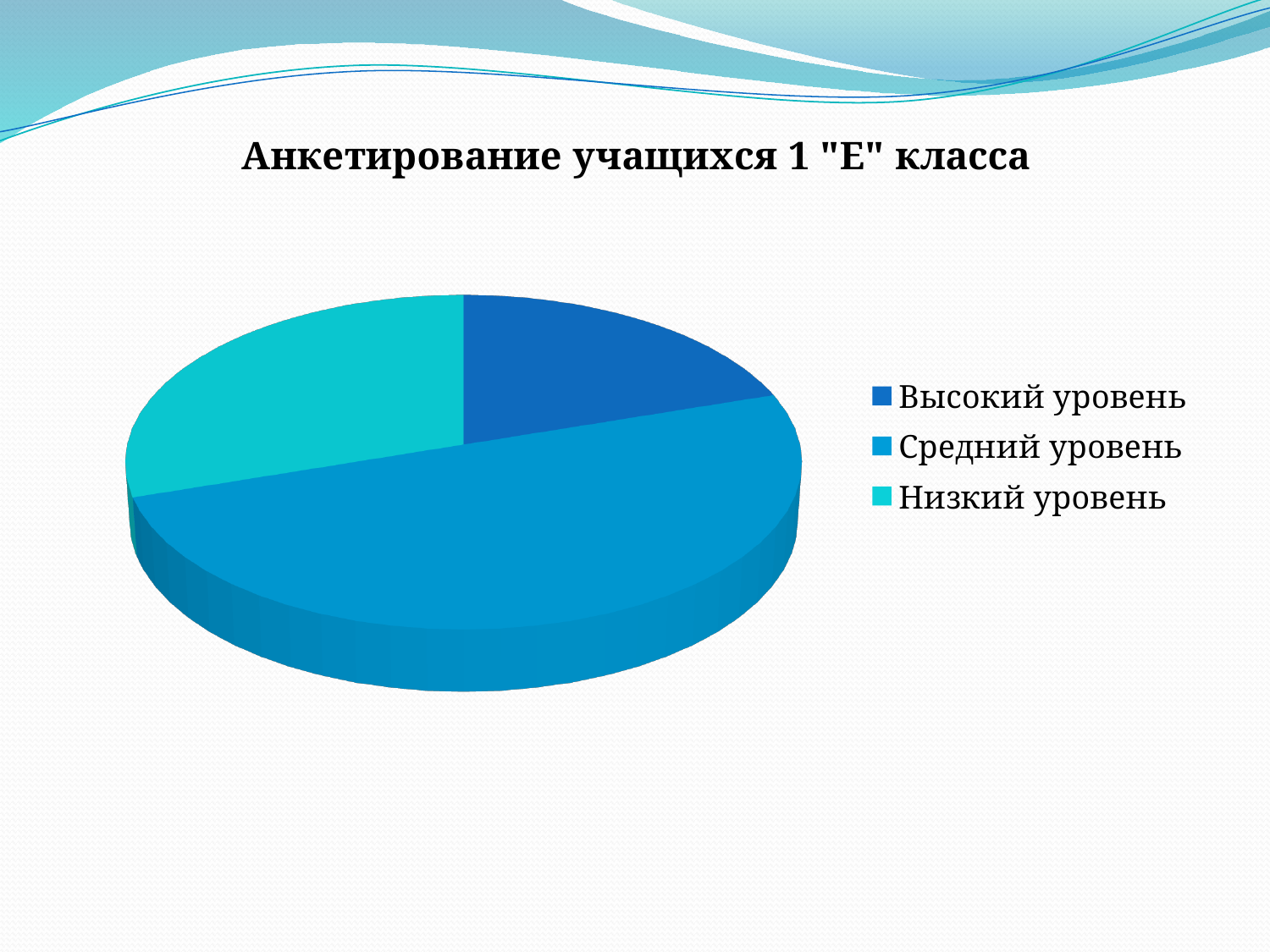
What is the title of the slide? Анкетирование учащихся 1 "Е" класса How many slices does the pie chart have? 3 Which category has the smallest slice of the pie? Высокий уровень Which category has the largest slice of the pie? Средний уровень How many entries does the legend list? 3 What kind of chart is shown on the slide? Pie chart Which slice is larger, Средний уровень or Низкий уровень? Средний уровень Which legend entry is shown in the darkest blue colour? Высокий уровень Which slice is larger, Низкий уровень or Высокий уровень? Низкий уровень